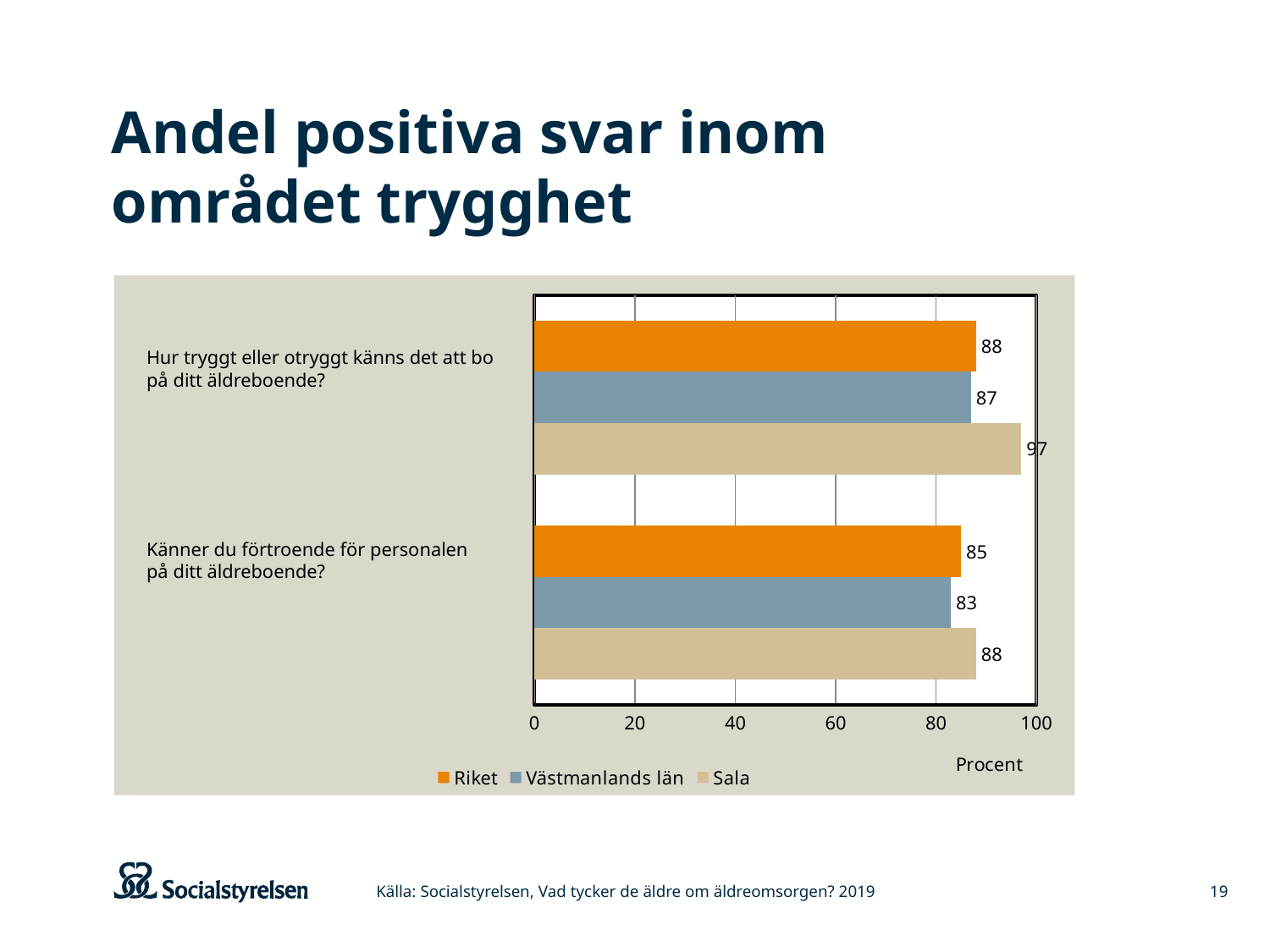
What kind of chart is shown on the slide? Bar chart Which is larger: the Sala value for "Känner du förtroende för personalen på ditt äldreboende?" or the Sala value for "Hur tryggt eller otryggt känns det att bo på ditt äldreboende?"? Hur tryggt eller otryggt känns det att bo på ditt äldreboende? Which series has the highest value on the question "Hur tryggt eller otryggt känns det att bo på ditt äldreboende?"? Sala What is the value for Sala on the question "Hur tryggt eller otryggt känns det att bo på ditt äldreboende?"? 97 What is the label on the horizontal axis of the chart? Procent What is the value for Västmanlands län on the question "Hur tryggt eller otryggt känns det att bo på ditt äldreboende?"? 87 Which series has the lowest value on the question "Känner du förtroende för personalen på ditt äldreboende?"? Västmanlands län What is the difference between the Riket value and the Västmanlands län value on the question "Känner du förtroende för personalen på ditt äldreboende?"? 2 What is the value for Riket on the question "Känner du förtroende för personalen på ditt äldreboende?"? 85 What is the difference between the Sala value and the Riket value on the question "Hur tryggt eller otryggt känns det att bo på ditt äldreboende?"? 9 How many series does the legend list? 3 What is the value for Västmanlands län on the question "Känner du förtroende för personalen på ditt äldreboende?"? 83